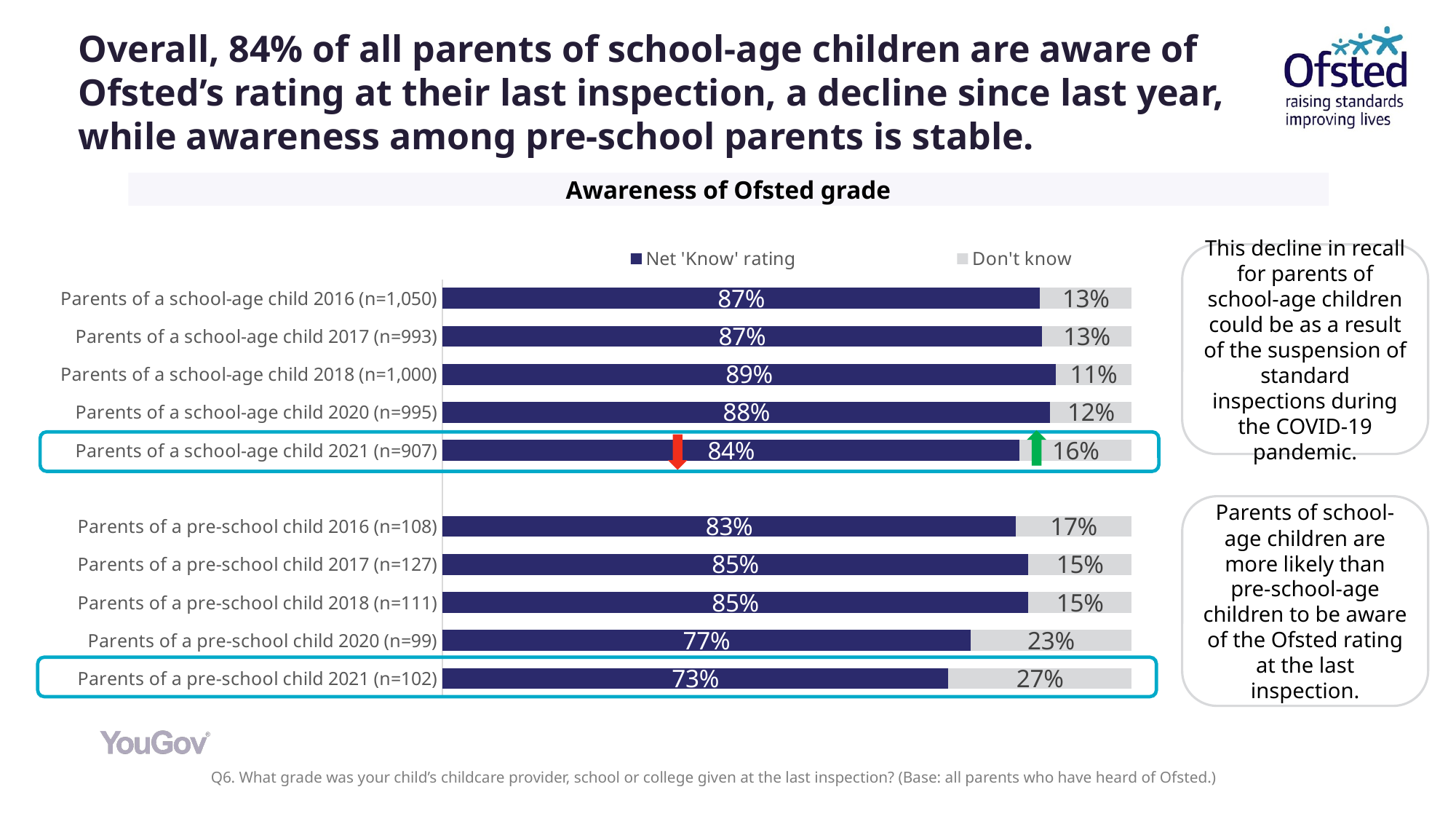
How many categories (bars) are shown in the chart? 10 Which is larger: the Don't know value for Parents of a pre-school child 2016 (n=108) or for Parents of a pre-school child 2020 (n=99)? Parents of a pre-school child 2020 (n=99) Which category has the lowest Net 'Know' rating value? Parents of a pre-school child 2021 (n=102) What is the total of the stacked bar for Parents of a pre-school child 2018 (n=111)? 100% Which category has the highest Net 'Know' rating value? Parents of a school-age child 2018 (n=1,000) What is the difference between the Net 'Know' rating for Parents of a school-age child 2020 (n=995) and Parents of a school-age child 2021 (n=907)? 4% What is the Don't know value for Parents of a pre-school child 2021 (n=102)? 27% What kind of chart is shown on the slide? Stacked bar chart What is the Net 'Know' rating value for Parents of a pre-school child 2020 (n=99)? 77% What is the title of the chart? Awareness of Ofsted grade What is the Net 'Know' rating value for Parents of a school-age child 2021 (n=907)? 84% How many series does the legend list? 2